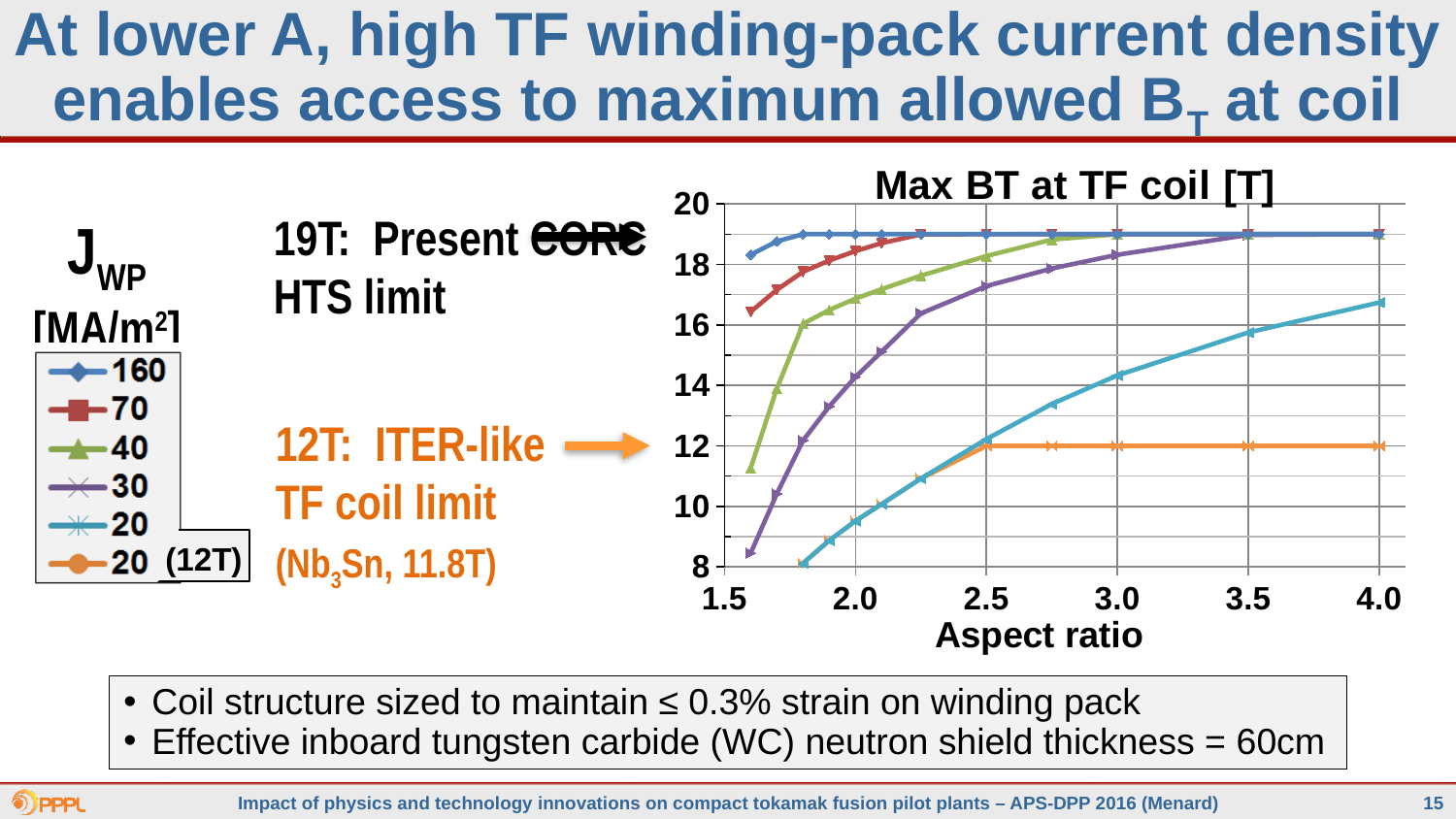
At an aspect ratio of 3.0, which series has the larger value, 40 or 20? 40 How many series does the chart's legend list? 6 What kind of chart is shown on the slide? line chart Is the value of the 40 series at an aspect ratio of 1.6 greater or less than 12? less What is the value of the 20 (12T) series at an aspect ratio of 3.0? 12 What is the title of the chart? Max BT at TF coil [T] Which series has the highest value at an aspect ratio of 1.6? 160 Does the 20 series rise or fall as the aspect ratio increases from 1.8 to 4.0? rise Is the value of the 20 series at an aspect ratio of 4.0 greater or less than 16? greater Is the value of the 70 series at an aspect ratio of 1.6 greater or less than 18? less Which series has the lowest value at an aspect ratio of 4.0? 20 (12T) What is the label of the x axis of the chart? Aspect ratio